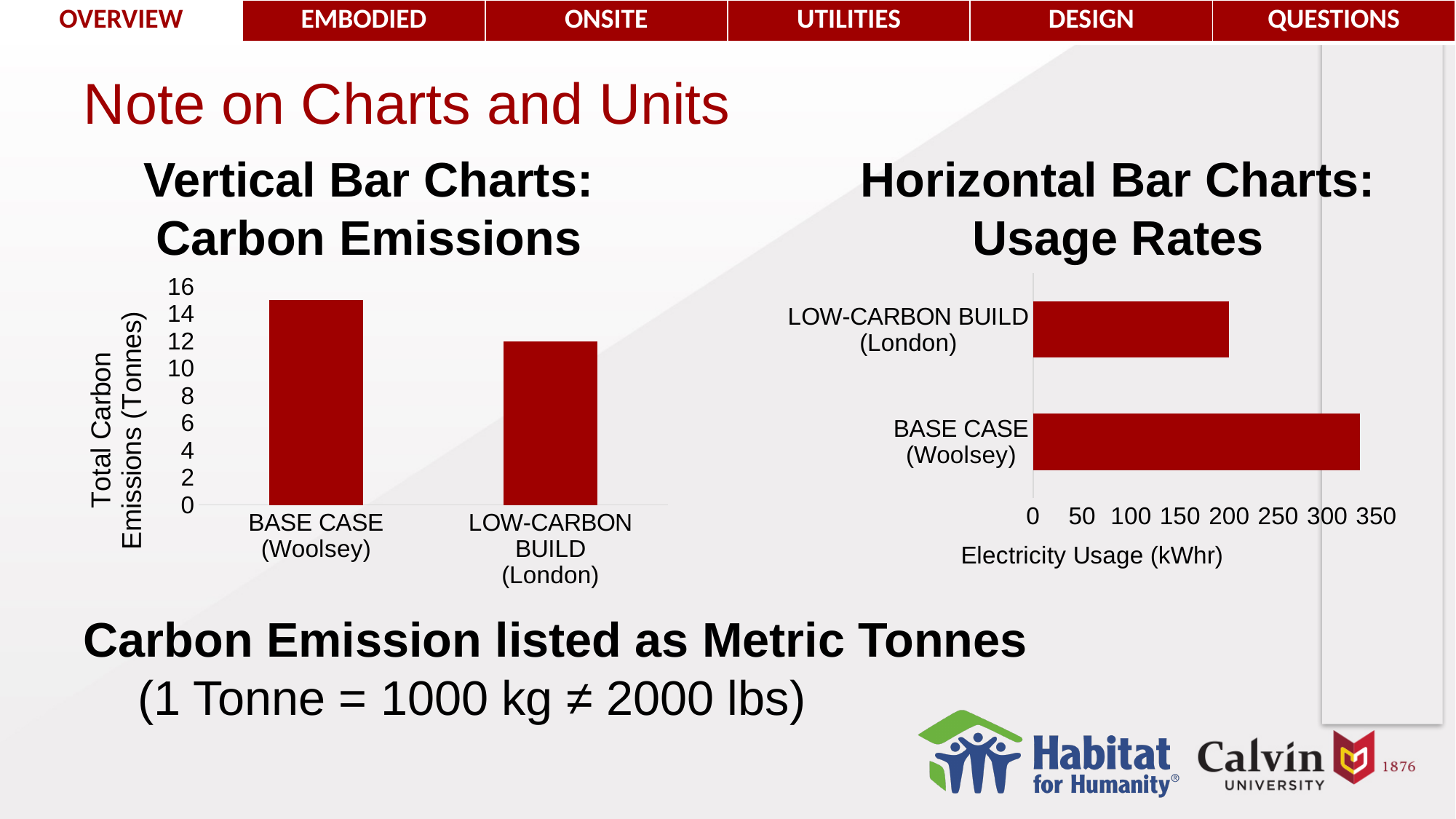
In the Usage Rates chart, is the value for LOW-CARBON BUILD (London) greater or less than 250? less What is the y-axis label of the Carbon Emissions chart? Total Carbon Emissions (Tonnes) How many categories are shown in the Carbon Emissions chart? 2 In the Carbon Emissions chart, is the value for LOW-CARBON BUILD (London) greater or less than 14? less What kind of chart is the Carbon Emissions chart on the left? bar chart In the Carbon Emissions chart, which category has the lowest value? LOW-CARBON BUILD (London) What kind of chart is the Usage Rates chart on the right? bar chart In the Carbon Emissions chart, which category has the highest value? BASE CASE (Woolsey) What is the x-axis label of the Usage Rates chart? Electricity Usage (kWhr) In the Usage Rates chart, is the value for BASE CASE (Woolsey) greater or less than 300? greater In the Usage Rates chart, which category has the highest electricity usage? BASE CASE (Woolsey)